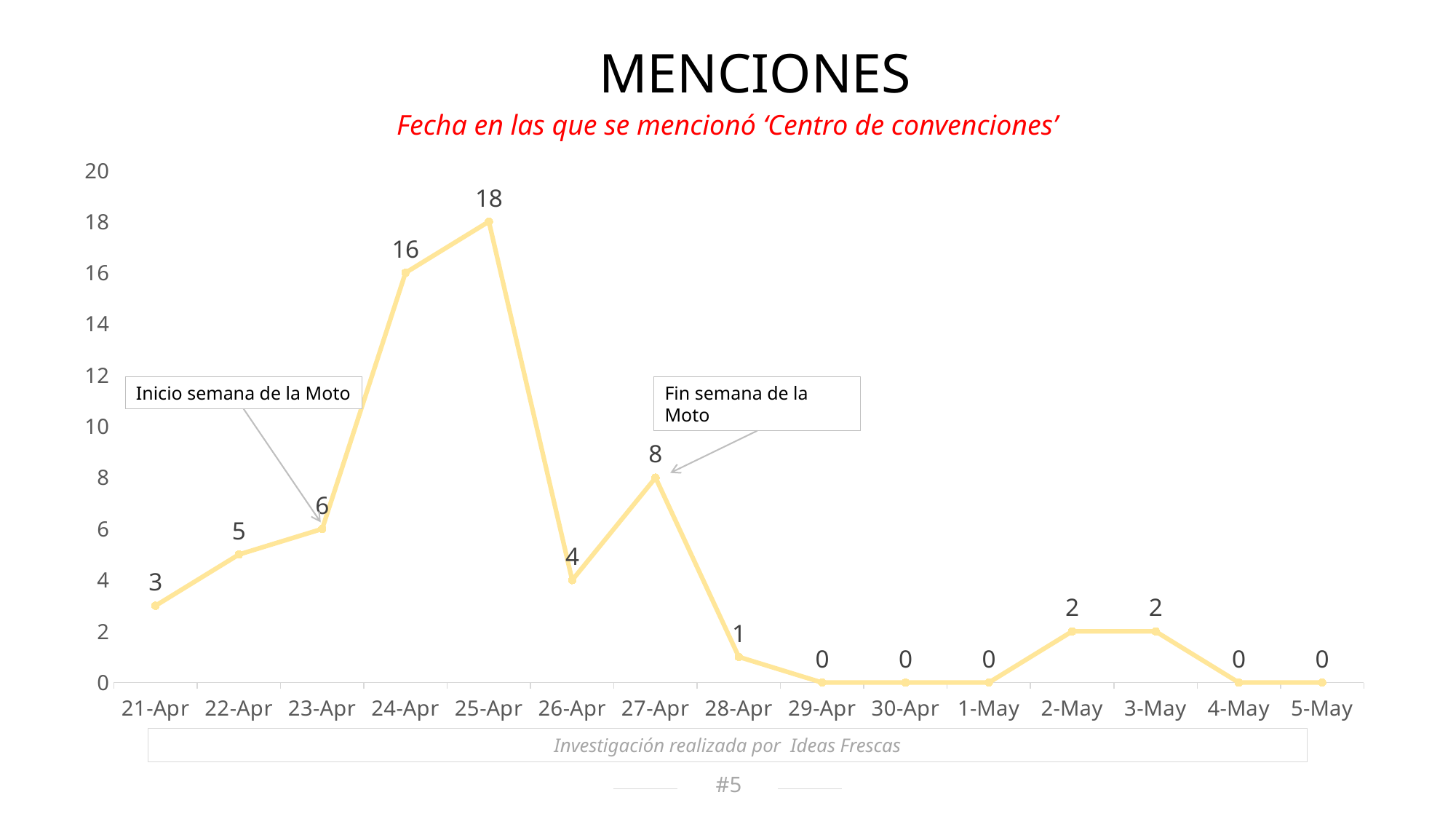
What is the difference between the values for 25-Apr and 26-Apr? 14 What is the value for 21-Apr? 3 What type of chart is shown on the slide? line chart How many dates have a value of 0? 5 What is the value for 27-Apr? 8 Do the values rise or fall from 27-Apr to 29-Apr? fall How many dates are plotted on the x axis? 15 On which date is the number of mentions highest? 25-Apr How many mentions were recorded on 25-Apr? 18 What does the annotation pointing to the 23-Apr point say? Inicio semana de la Moto Which has a larger value, 22-Apr or 23-Apr? 23-Apr What is the value for 24-Apr? 16